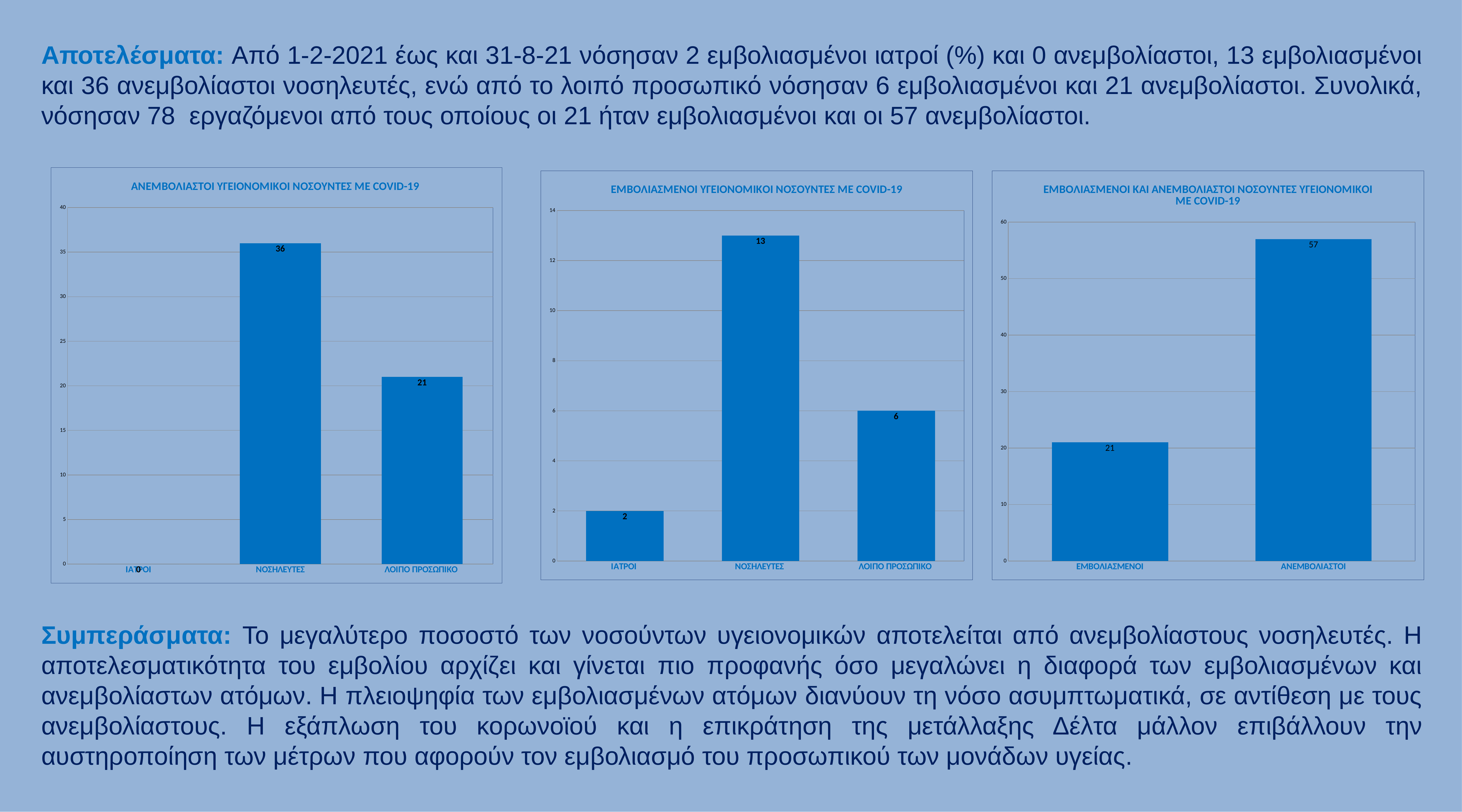
In the left chart (ΑΝΕΜΒΟΛΙΑΣΤΟΙ ΥΓΕΙΟΝΟΜΙΚΟΙ ΝΟΣΟΥΝΤΕΣ ΜΕ COVID-19), what is the value for ΛΟΙΠΟ ΠΡΟΣΩΠΙΚΟ? 21 In the middle chart (ΕΜΒΟΛΙΑΣΜΕΝΟΙ ΥΓΕΙΟΝΟΜΙΚΟΙ ΝΟΣΟΥΝΤΕΣ ΜΕ COVID-19), how many categories are shown on the x axis? 3 In the middle chart (ΕΜΒΟΛΙΑΣΜΕΝΟΙ ΥΓΕΙΟΝΟΜΙΚΟΙ ΝΟΣΟΥΝΤΕΣ ΜΕ COVID-19), what is the value for ΛΟΙΠΟ ΠΡΟΣΩΠΙΚΟ? 6 In the right chart (ΕΜΒΟΛΙΑΣΜΕΝΟΙ ΚΑΙ ΑΝΕΜΒΟΛΙΑΣΤΟΙ ΝΟΣΟΥΝΤΕΣ ΥΓΕΙΟΝΟΜΙΚΟΙ ΜΕ COVID-19), which is larger, ΕΜΒΟΛΙΑΣΜΕΝΟΙ or ΑΝΕΜΒΟΛΙΑΣΤΟΙ? ΑΝΕΜΒΟΛΙΑΣΤΟΙ In the right chart (ΕΜΒΟΛΙΑΣΜΕΝΟΙ ΚΑΙ ΑΝΕΜΒΟΛΙΑΣΤΟΙ ΝΟΣΟΥΝΤΕΣ ΥΓΕΙΟΝΟΜΙΚΟΙ ΜΕ COVID-19), what is the difference between ΑΝΕΜΒΟΛΙΑΣΤΟΙ and ΕΜΒΟΛΙΑΣΜΕΝΟΙ? 36 In the middle chart (ΕΜΒΟΛΙΑΣΜΕΝΟΙ ΥΓΕΙΟΝΟΜΙΚΟΙ ΝΟΣΟΥΝΤΕΣ ΜΕ COVID-19), which category has the highest value? ΝΟΣΗΛΕΥΤΕΣ What type of chart is the right chart (ΕΜΒΟΛΙΑΣΜΕΝΟΙ ΚΑΙ ΑΝΕΜΒΟΛΙΑΣΤΟΙ ΝΟΣΟΥΝΤΕΣ ΥΓΕΙΟΝΟΜΙΚΟΙ ΜΕ COVID-19)? Bar chart In the left chart (ΑΝΕΜΒΟΛΙΑΣΤΟΙ ΥΓΕΙΟΝΟΜΙΚΟΙ ΝΟΣΟΥΝΤΕΣ ΜΕ COVID-19), what is the difference between ΝΟΣΗΛΕΥΤΕΣ and ΛΟΙΠΟ ΠΡΟΣΩΠΙΚΟ? 15 In the right chart (ΕΜΒΟΛΙΑΣΜΕΝΟΙ ΚΑΙ ΑΝΕΜΒΟΛΙΑΣΤΟΙ ΝΟΣΟΥΝΤΕΣ ΥΓΕΙΟΝΟΜΙΚΟΙ ΜΕ COVID-19), what is the value for ΑΝΕΜΒΟΛΙΑΣΤΟΙ? 57 In the left chart (ΑΝΕΜΒΟΛΙΑΣΤΟΙ ΥΓΕΙΟΝΟΜΙΚΟΙ ΝΟΣΟΥΝΤΕΣ ΜΕ COVID-19), which category has the lowest value? ΙΑΤΡΟΙ In the left chart (ΑΝΕΜΒΟΛΙΑΣΤΟΙ ΥΓΕΙΟΝΟΜΙΚΟΙ ΝΟΣΟΥΝΤΕΣ ΜΕ COVID-19), what is the value for ΝΟΣΗΛΕΥΤΕΣ? 36 In the middle chart (ΕΜΒΟΛΙΑΣΜΕΝΟΙ ΥΓΕΙΟΝΟΜΙΚΟΙ ΝΟΣΟΥΝΤΕΣ ΜΕ COVID-19), what is the value for ΙΑΤΡΟΙ? 2